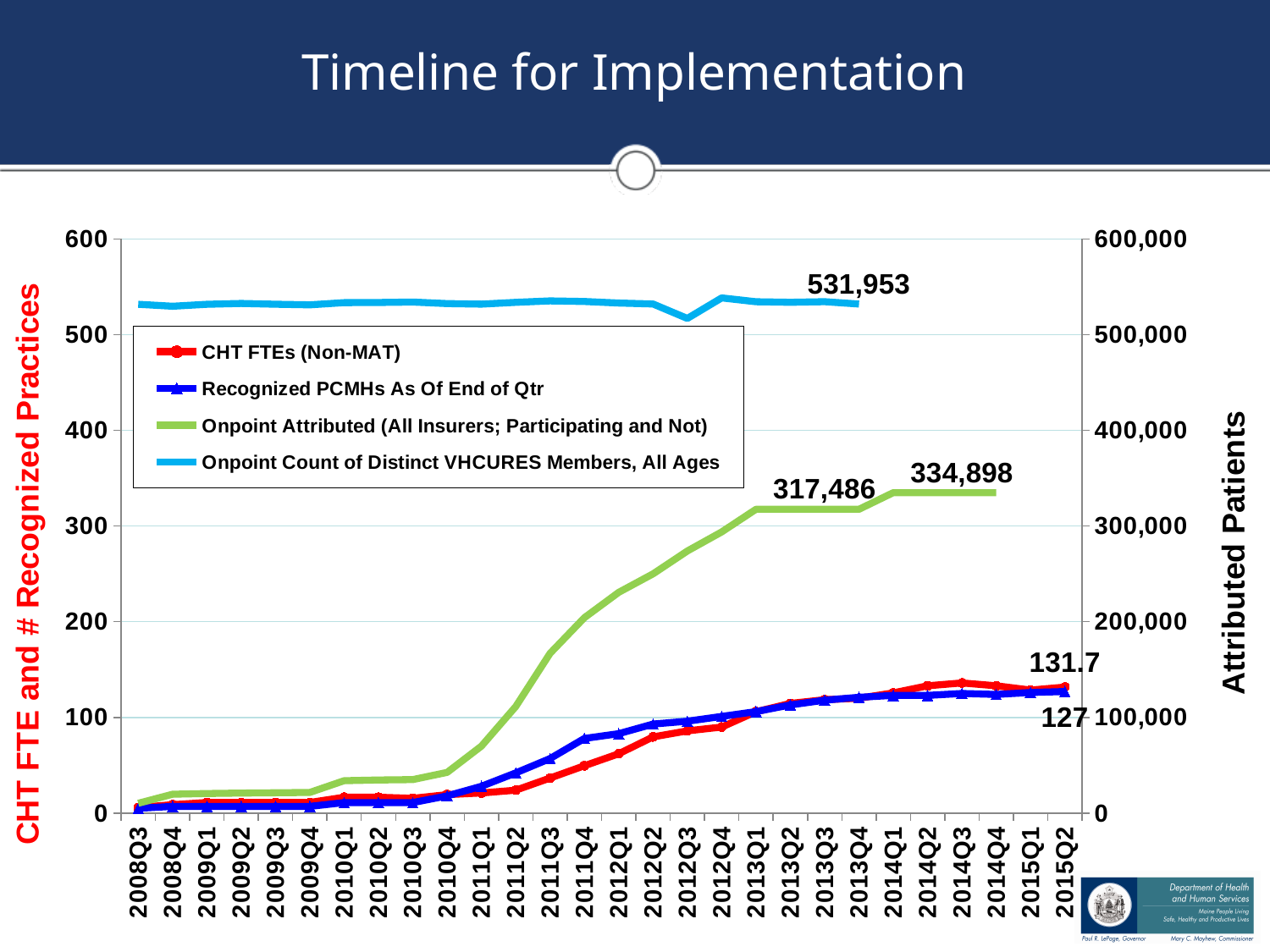
What is the labelled value of CHT FTEs (Non-MAT) at 2015Q2? 131.7 What is the labelled value of Onpoint Attributed (All Insurers; Participating and Not) at 2013Q1? 317,486 What is the labelled value of Recognized PCMHs As Of End of Qtr at 2015Q2? 127 At 2015Q2, which is larger: CHT FTEs (Non-MAT) or Recognized PCMHs As Of End of Qtr? CHT FTEs (Non-MAT) What is the labelled value of Onpoint Attributed (All Insurers; Participating and Not) at 2014Q4? 334,898 How many series does the legend list? 4 What type of chart is shown on the slide? line chart Is the value for Recognized PCMHs As Of End of Qtr at 2011Q4 greater or less than 100? less What is the difference between the Onpoint Attributed labels 334,898 and 317,486? 17,412 How many quarters are shown on the x axis? 28 What is the labelled value of Onpoint Count of Distinct VHCURES Members, All Ages at its last point? 531,953 Does the Onpoint Attributed (All Insurers; Participating and Not) series rise or fall from 2008Q3 to 2014Q4? rise